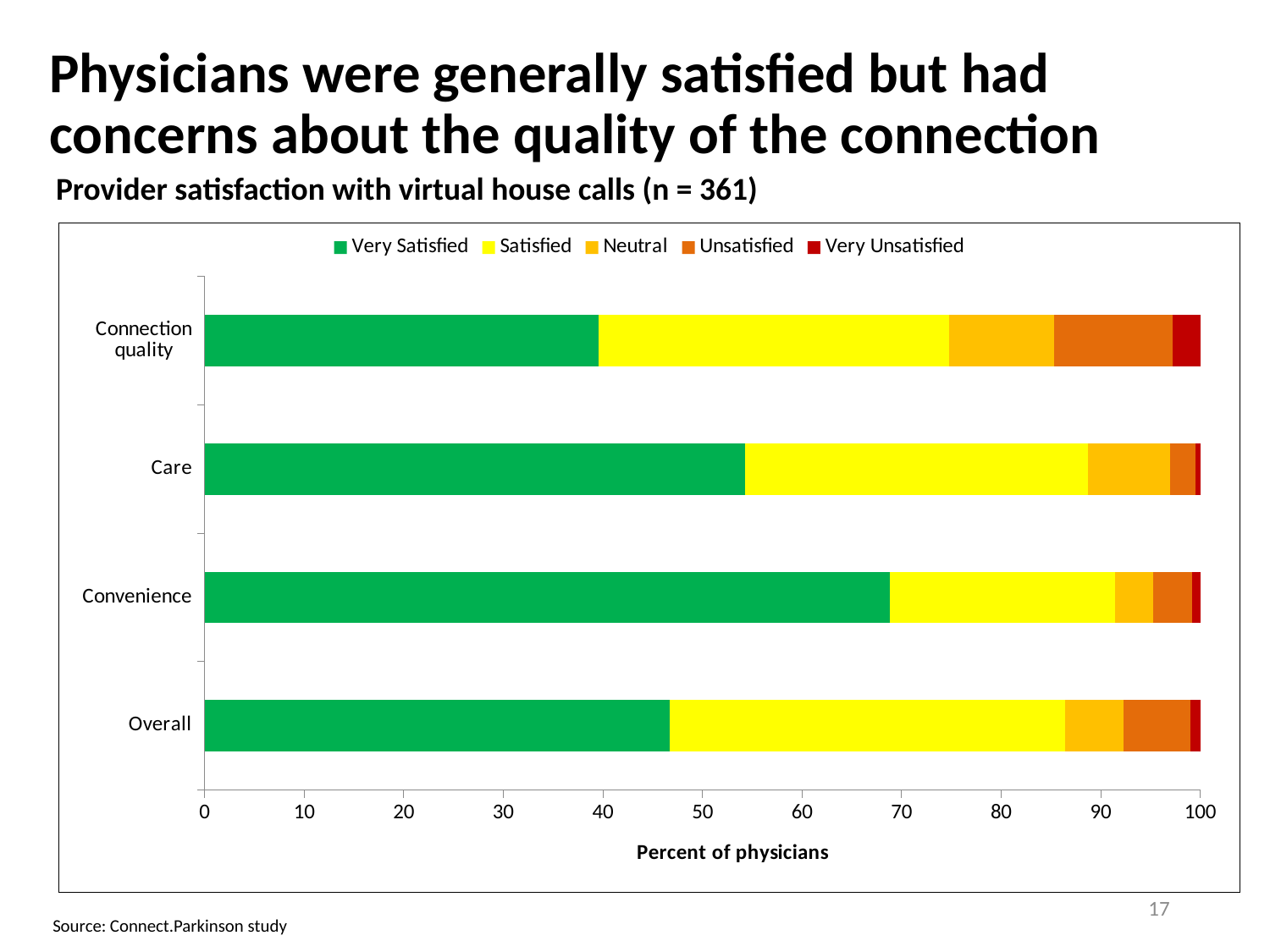
What kind of chart is shown on the slide? Stacked bar chart Is the Very Satisfied value for Convenience greater or less than 60? greater How many series does the legend list? 5 What is the title of the chart? Provider satisfaction with virtual house calls (n = 361) Which category has the largest Very Satisfied segment? Convenience Is the Very Satisfied value for Connection quality greater or less than 50? less Which category has the smallest Very Satisfied segment? Connection quality Is the Very Satisfied value for Overall greater or less than 40? greater How many categories are plotted on the chart? 4 Is the Very Satisfied segment larger for Care or for Connection quality? Care Which category has the largest Unsatisfied segment? Connection quality What is the label of the horizontal axis? Percent of physicians